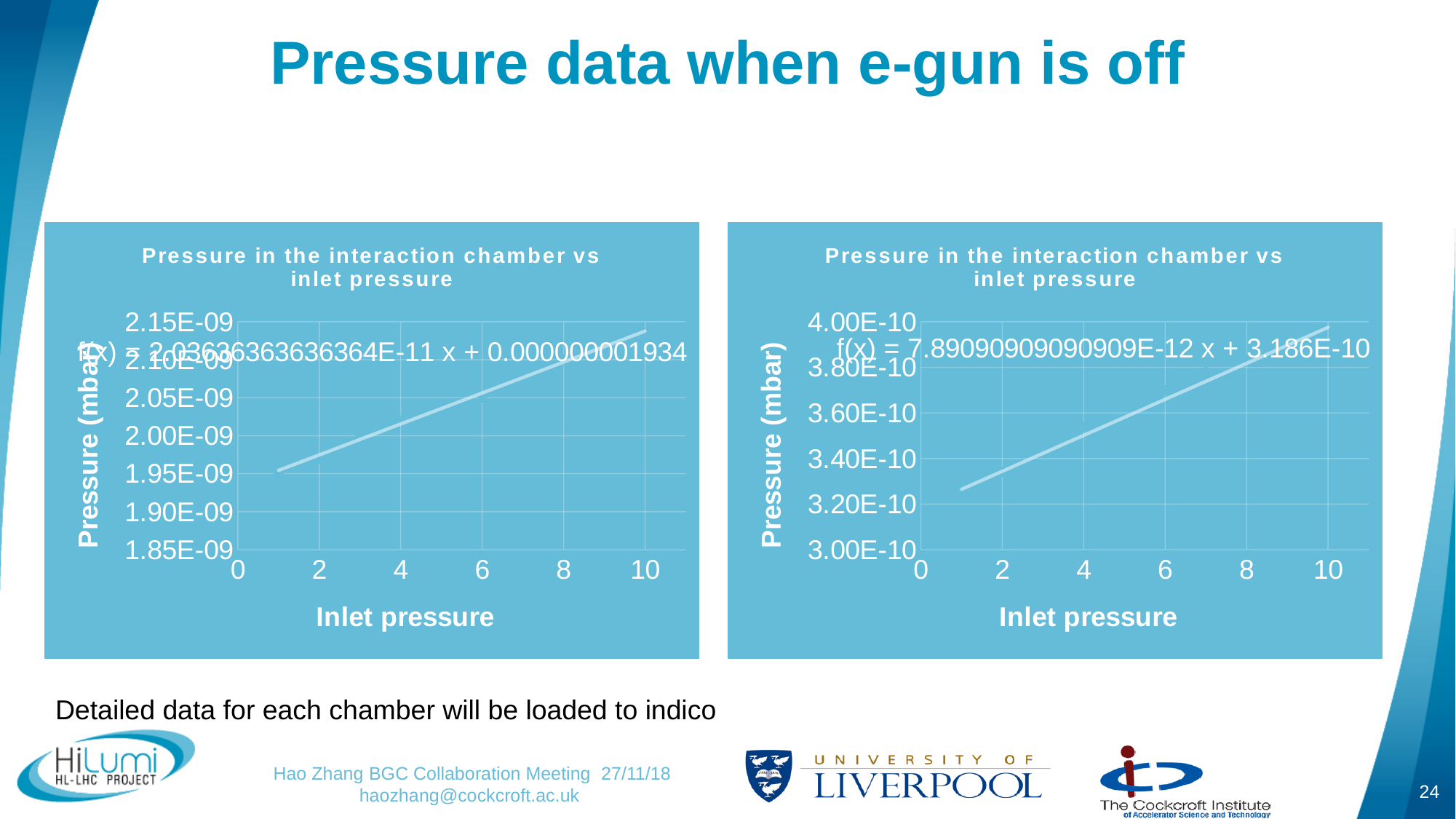
What is the title of the left chart? Pressure in the interaction chamber vs inlet pressure In the right chart, does the pressure rise or fall as inlet pressure increases along the x axis? rise What kind of chart is the right chart on the slide? line chart What is the y-axis label of the right chart? Pressure (mbar) In the left chart, does the pressure rise or fall as inlet pressure increases along the x axis? rise In the right chart, is the pressure at inlet pressure 10 greater or less than 3.80E-10? greater In the right chart, is the pressure at inlet pressure 1 greater or less than 3.40E-10? less In the left chart, is the pressure at inlet pressure 1 greater or less than 2.00E-09? less What kind of chart is the left chart on the slide? line chart